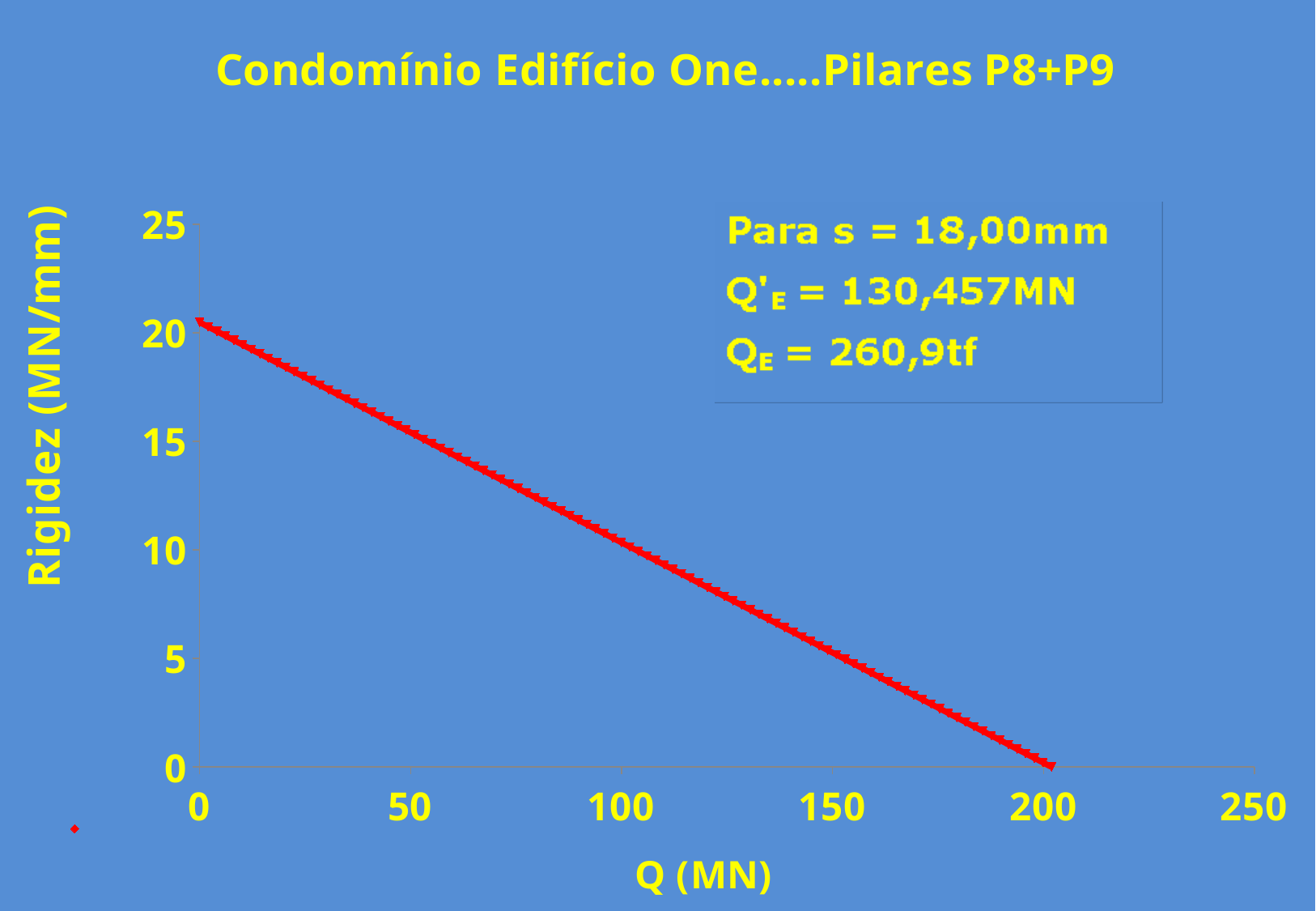
Is the Rigidez value at Q = 0 MN greater or less than 15? greater Is the Rigidez value at Q = 200 MN greater or less than 5? less Is the Rigidez value at Q = 100 MN greater or less than 15? less What is the title of the chart? Condomínio Edifício One.....Pilares P8+P9 What kind of chart is shown on the slide? line chart What is the label of the y axis? Rigidez (MN/mm) Does the Rigidez value rise or fall as Q increases along the x axis? fall